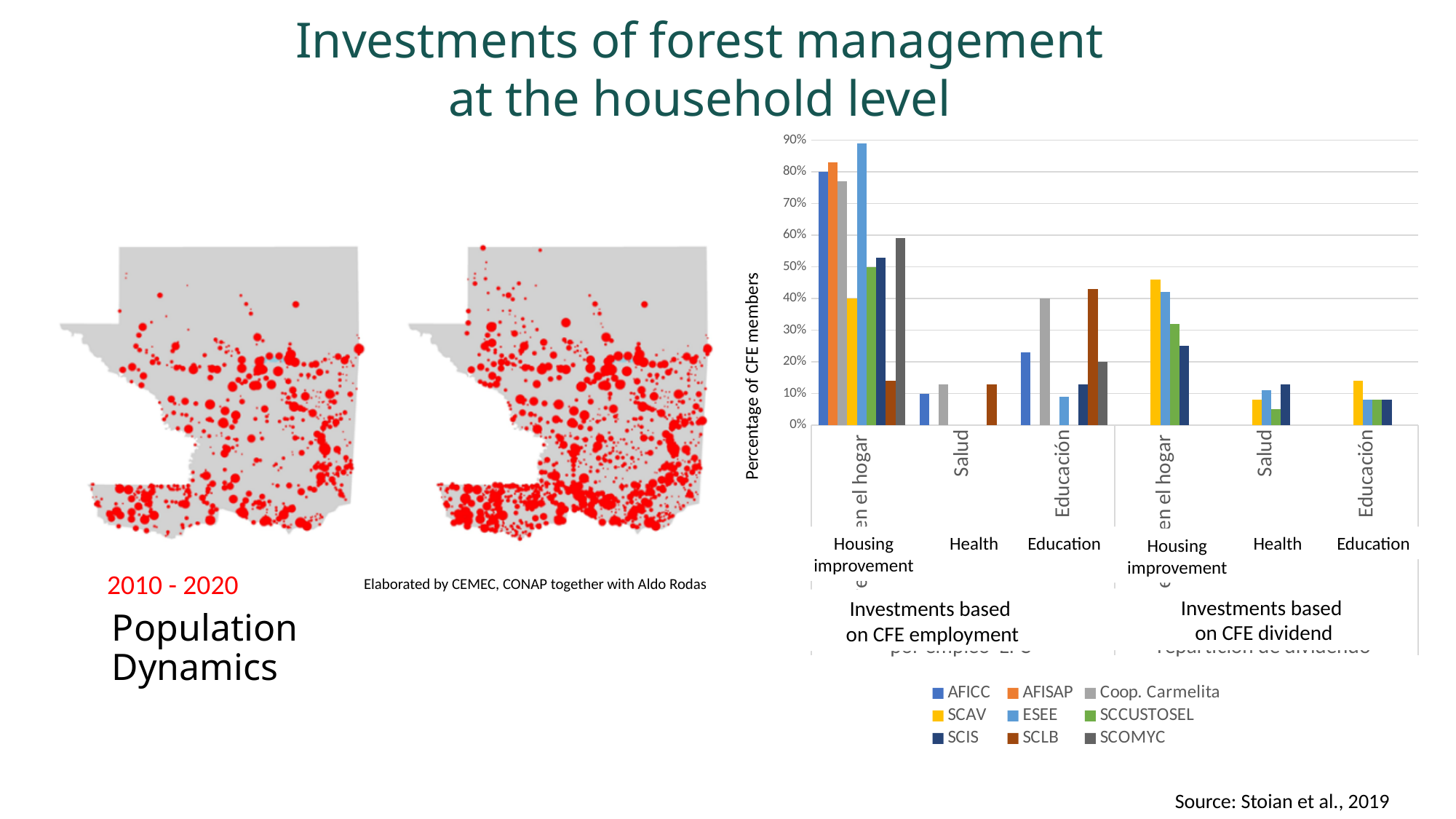
In the bar chart, is the value for SCOMYC for Housing improvement under 'Investments based on CFE employment' greater or less than 50%? greater In the bar chart, which is larger for Education under 'Investments based on CFE employment': Coop. Carmelita or AFICC? Coop. Carmelita In the bar chart, is the value for ESEE for Housing improvement under 'Investments based on CFE employment' greater or less than 80%? greater In the bar chart, how many investment categories are shown under 'Investments based on CFE employment'? 3 In the bar chart, what is the label of the vertical axis? Percentage of CFE members In the bar chart, which is larger for Health under 'Investments based on CFE dividend': SCIS or SCCUSTOSEL? SCIS What kind of chart is shown on the right side of the slide? bar chart In the bar chart, is the value for SCAV for Housing improvement under 'Investments based on CFE employment' greater or less than 50%? less In the bar chart, which series has the highest value for Housing improvement under 'Investments based on CFE dividend'? SCAV How many series does the legend of the bar chart list? 9 In the bar chart, which series has the highest value for Housing improvement under 'Investments based on CFE employment'? ESEE